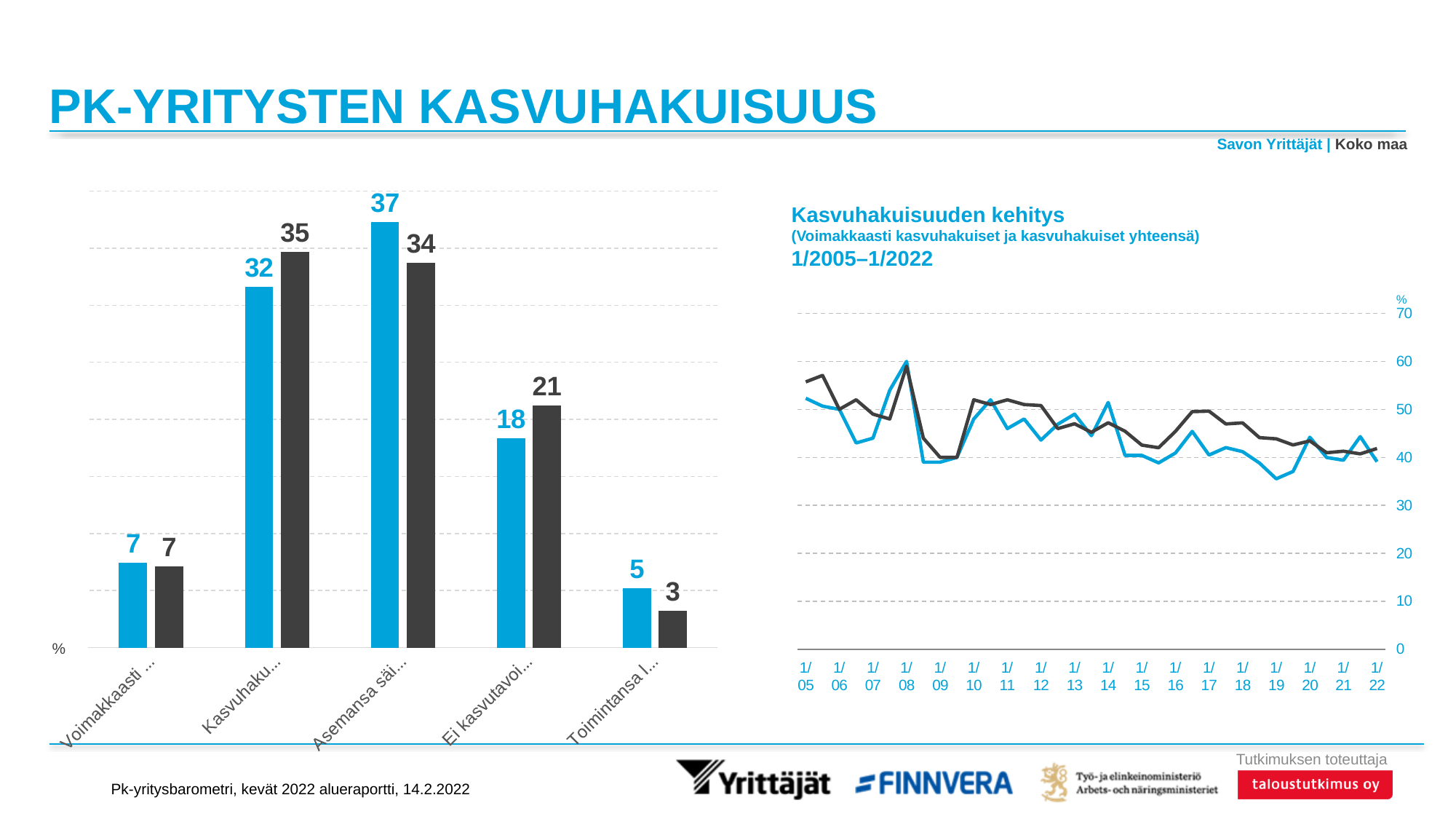
In the bar chart on the left, what is the difference between the Koko maa and Savon Yrittäjät values for the category "Ei kasvutavoi..."? 3 What kind of chart is the chart on the left of the slide? bar chart How many series does the legend at the top right list? 2 In the bar chart on the left, what is the value of the dark (Koko maa) bar for the fourth category, "Ei kasvutavoi..."? 21 What kind of chart is "Kasvuhakuisuuden kehitys" on the right of the slide? line chart In the bar chart on the left, for the category "Kasvuhaku...", which series has the larger value, Savon Yrittäjät or Koko maa? Koko maa In the "Kasvuhakuisuuden kehitys" chart, do the values generally rise or fall from 1/05 to 1/22? fall In the bar chart on the left, which category has the highest blue (Savon Yrittäjät) bar? Asemansa säi... How many categories are shown in the bar chart on the left? 5 In the bar chart on the left, what is the value of the blue (Savon Yrittäjät) bar for the third category, "Asemansa säi..."? 37 In the bar chart on the left, which category has the lowest dark (Koko maa) bar? Toimintansa l... In the "Kasvuhakuisuuden kehitys" chart, is the blue line's value at 1/19 greater or less than 40? less